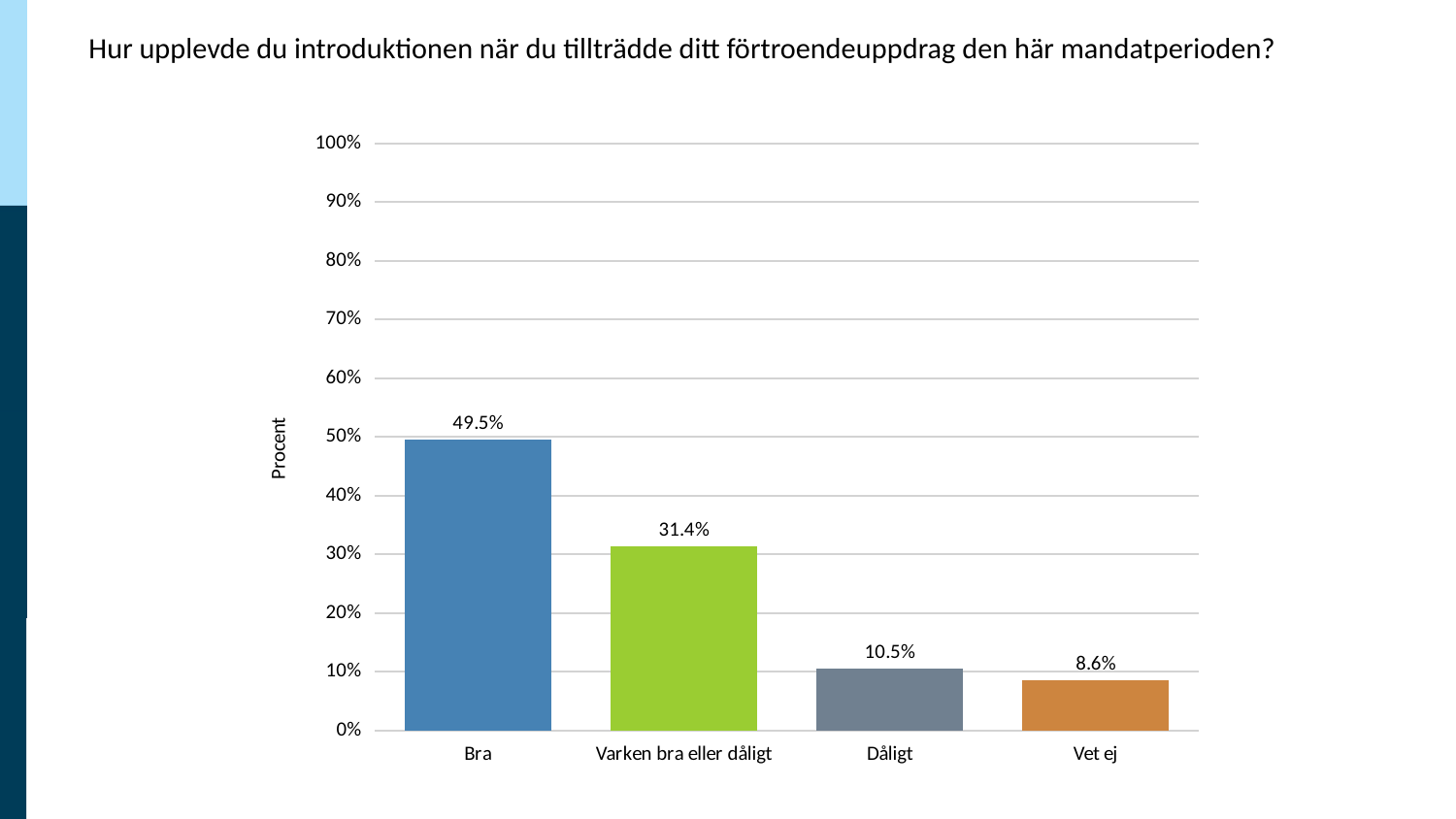
What is the label of the y axis? Procent What is the value for "Varken bra eller dåligt"? 31.4% Which category has the highest value? Bra What is the value for "Dåligt"? 10.5% How many categories are shown on the x axis? 4 What is the value for "Vet ej"? 8.6% What is the difference between the values for "Bra" and "Varken bra eller dåligt"? 18.1% What kind of chart is shown on the slide? bar chart Is the value for "Bra" greater or less than 40%? greater What is the value for "Bra"? 49.5% Which is larger, the value for "Dåligt" or the value for "Vet ej"? Dåligt Which category has the lowest value? Vet ej